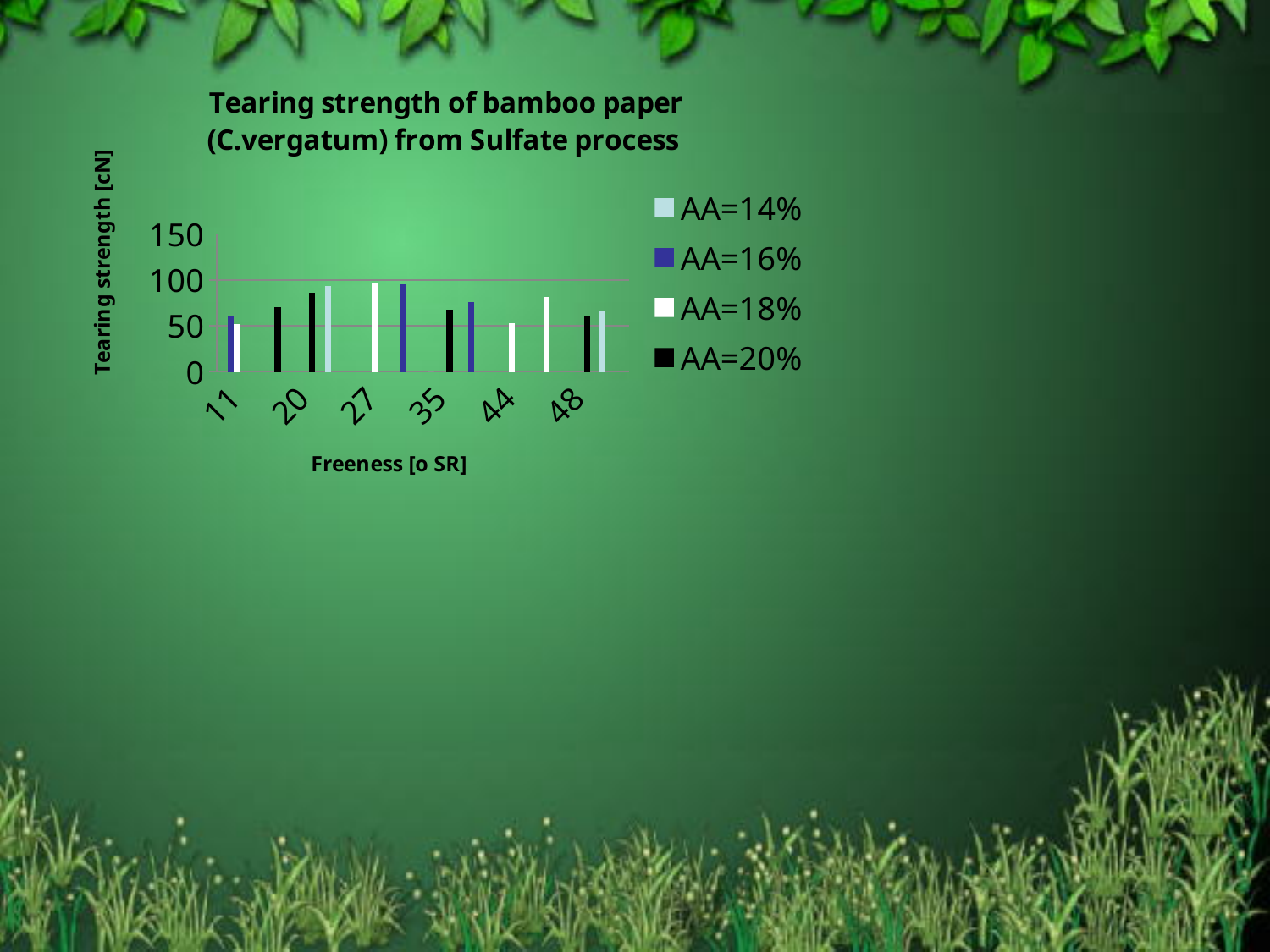
Are all the bars in the chart greater or less than 150? less What is the title of the chart? Tearing strength of bamboo paper (C.vergatum) from Sulfate process What kind of chart is shown on the slide? bar chart Which series is drawn in black in the legend? AA=20% How many freeness categories are shown on the x axis? 6 How many series does the legend list? 4